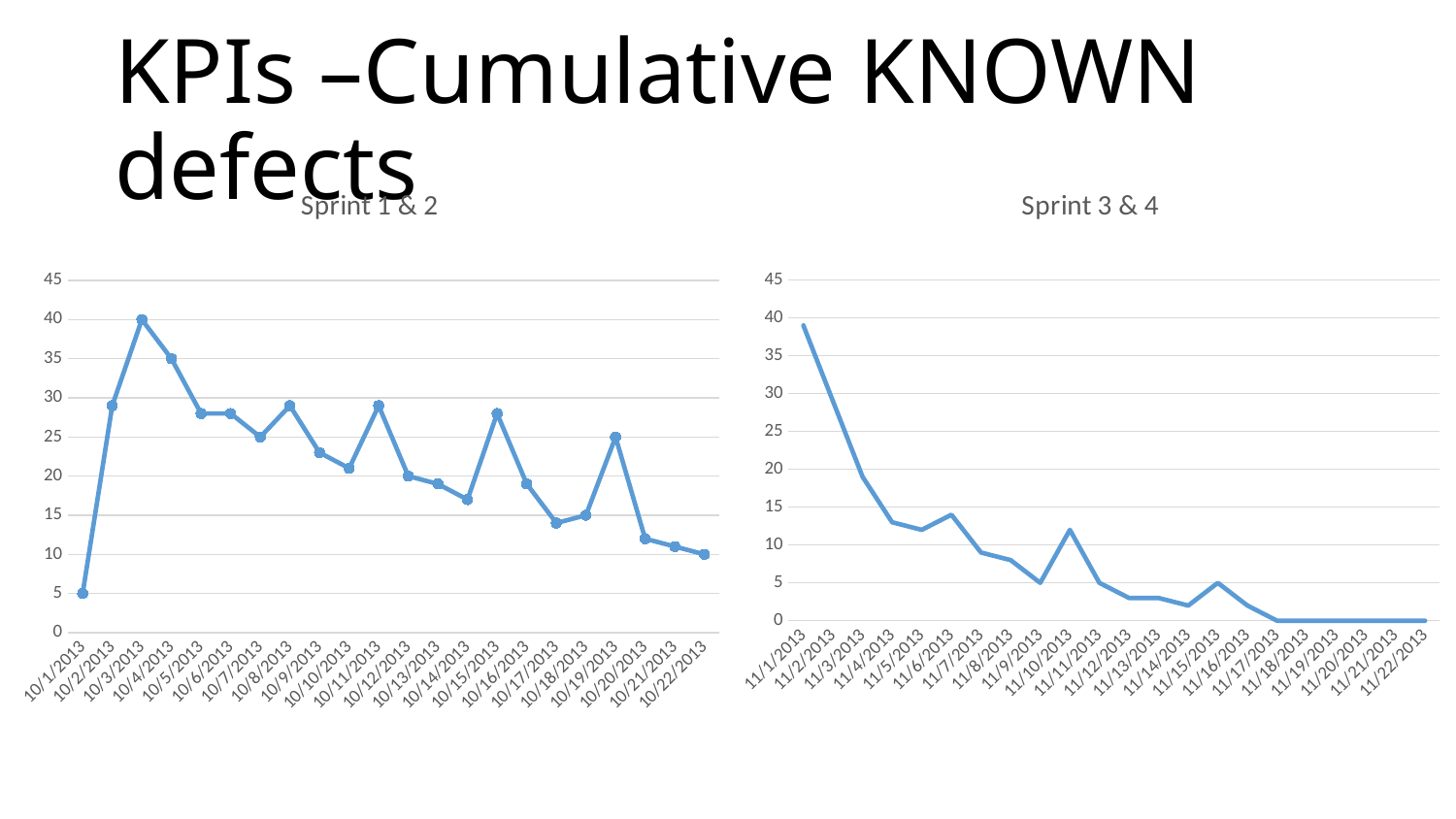
In the Sprint 1 & 2 chart, which date has the lowest value? 10/1/2013 In the Sprint 3 & 4 chart, what is the value for 11/22/2013? 0 In the Sprint 3 & 4 chart, which date has the highest value? 11/1/2013 In the Sprint 1 & 2 chart, what is the value for 10/3/2013? 40 In the Sprint 3 & 4 chart, do the values generally rise or fall from 11/1/2013 to 11/22/2013? fall In the Sprint 1 & 2 chart, what is the value for 10/1/2013? 5 How many data points are plotted in the Sprint 3 & 4 chart? 22 In the Sprint 1 & 2 chart, is the value for 10/2/2013 greater or less than 25? greater In the Sprint 1 & 2 chart, which is larger, the value for 10/3/2013 or 10/4/2013? 10/3/2013 What kind of chart is the Sprint 1 & 2 chart? line chart In the Sprint 3 & 4 chart, is the value for 11/1/2013 greater or less than 35? greater In the Sprint 1 & 2 chart, which date has the highest value? 10/3/2013